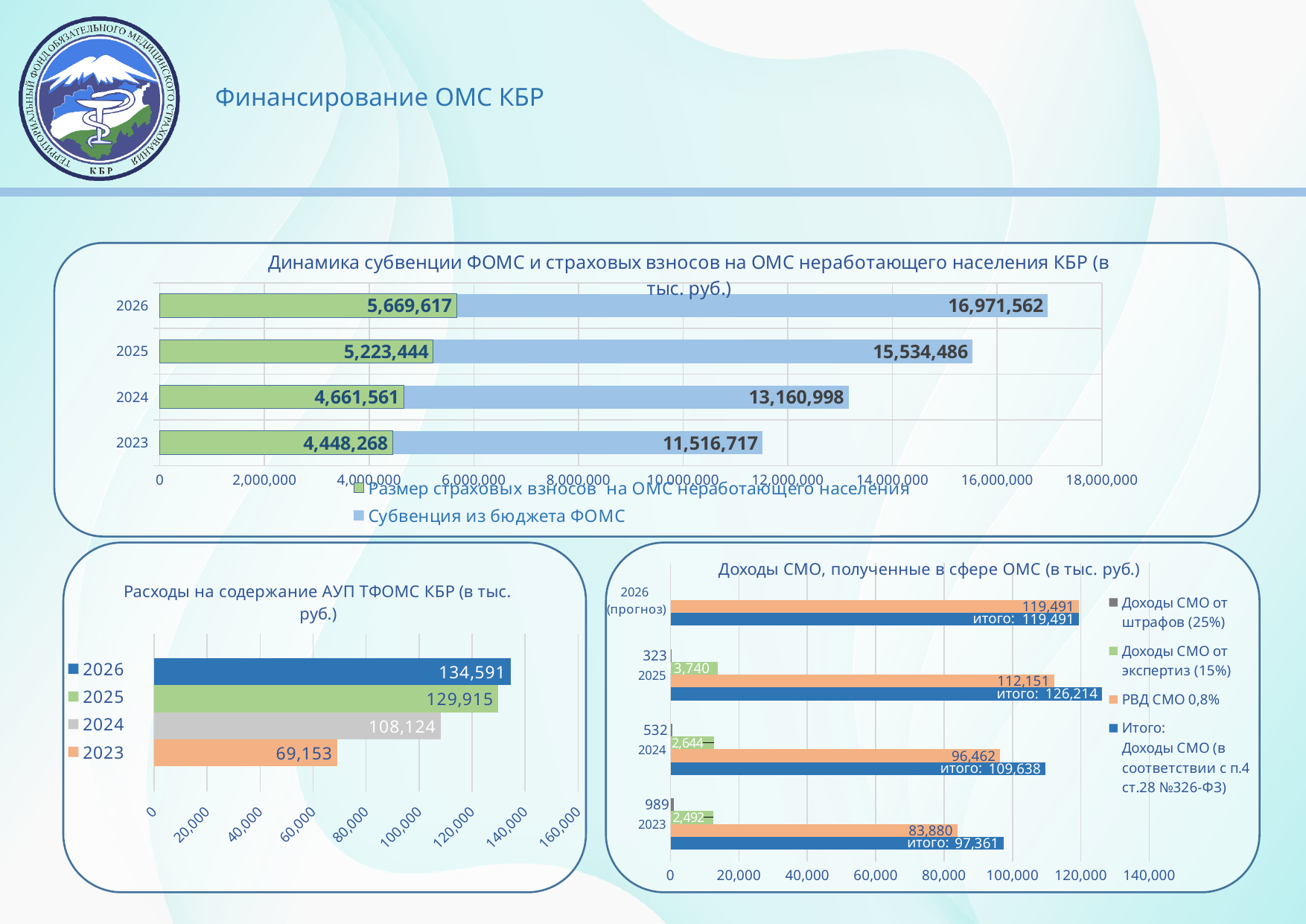
In the chart 'Доходы СМО, полученные в сфере ОМС', what is the value of 'Доходы СМО от экспертиз (15%)' for 2024? 12,644 In the chart 'Динамика субвенции ФОМС и страховых взносов на ОМС неработающего населения КБР', what is the difference between the 'Субвенция из бюджета ФОМС' values for 2025 and 2024? 2,373,488 What kind of chart is 'Расходы на содержание АУП ТФОМС КБР'? Bar chart In the chart 'Динамика субвенции ФОМС и страховых взносов на ОМС неработающего населения КБР', how many series does the legend list? 2 In the chart 'Расходы на содержание АУП ТФОМС КБР', what is the difference between the values for 2025 and 2023? 60,762 In the chart 'Динамика субвенции ФОМС и страховых взносов на ОМС неработающего населения КБР', what is the value of 'Субвенция из бюджета ФОМС' for 2026? 16,971,562 In the chart 'Расходы на содержание АУП ТФОМС КБР', what is the value for 2024? 108,124 In the chart 'Доходы СМО, полученные в сфере ОМС', which is larger: the 'РВД СМО 0,8%' value for 2023 or for 2024? 2024 In the chart 'Доходы СМО, полученные в сфере ОМС', what is the 'итого' value for 2025? 126,214 In the chart 'Расходы на содержание АУП ТФОМС КБР', which year has the highest value? 2026 In the chart 'Динамика субвенции ФОМС и страховых взносов на ОМС неработающего населения КБР', which year has the lowest value of 'Субвенция из бюджета ФОМС'? 2023 In the chart 'Динамика субвенции ФОМС и страховых взносов на ОМС неработающего населения КБР', what is the value of 'Размер страховых взносов на ОМС неработающего населения' for 2023? 4,448,268